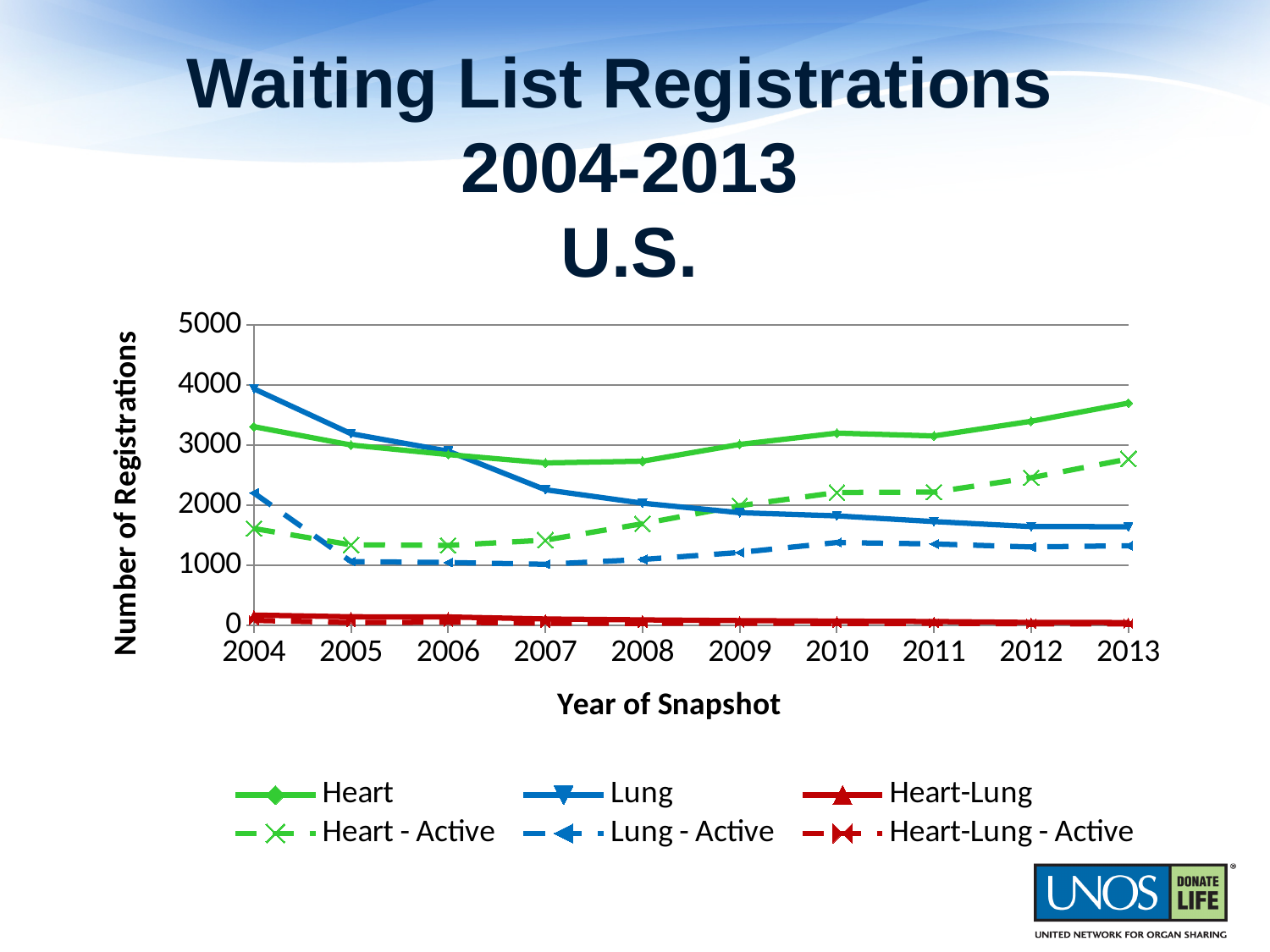
What kind of chart is shown on the slide? line chart Is the value for Heart-Lung in 2004 greater or less than 1000? less In which year does the Heart series reach its highest value? 2013 In 2004, which series has the larger value, Heart or Lung? Lung In 2013, which is larger, Heart - Active or Lung - Active? Heart - Active How many years are plotted along the x axis? 10 Is the value for Lung in 2004 greater or less than 3000? greater Is the value for Heart in 2013 greater or less than 3000? greater In 2013, which series has the larger value, Heart or Lung? Heart How many series does the legend list? 6 Does the Lung series rise or fall from 2004 to 2013? fall